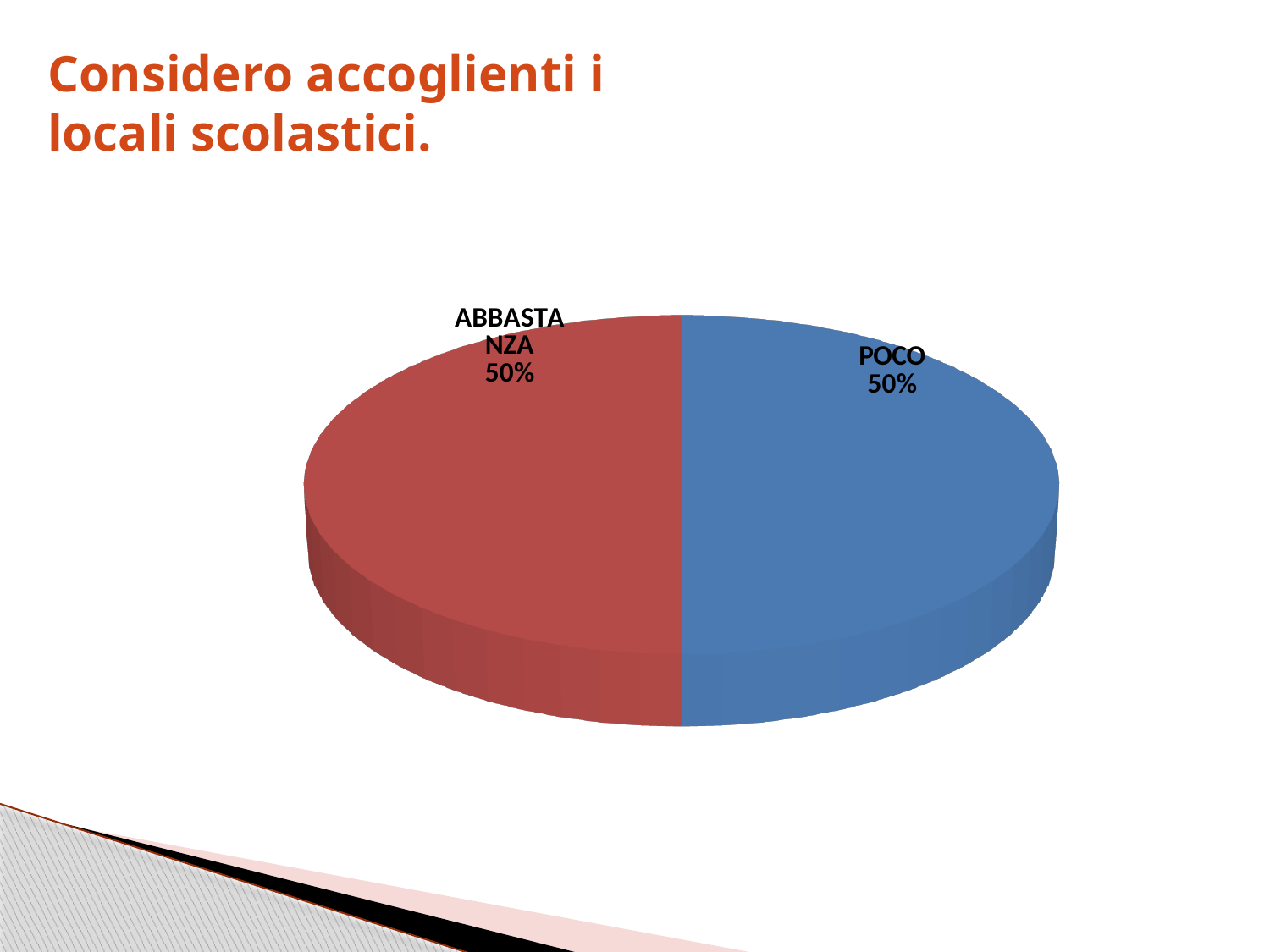
Is the value for POCO greater or less than 40%? greater Which colour is the ABBASTANZA slice? red What share of the pie does the POCO slice represent? 50% Which colour is the POCO slice? blue Is the value for ABBASTANZA greater or less than 60%? less What is the total of the POCO and ABBASTANZA shares? 100% What is the difference between the POCO and ABBASTANZA shares? 0% What share of the pie does the ABBASTANZA slice represent? 50% What kind of chart is shown on the slide? pie chart How many slices does the pie chart have? 2